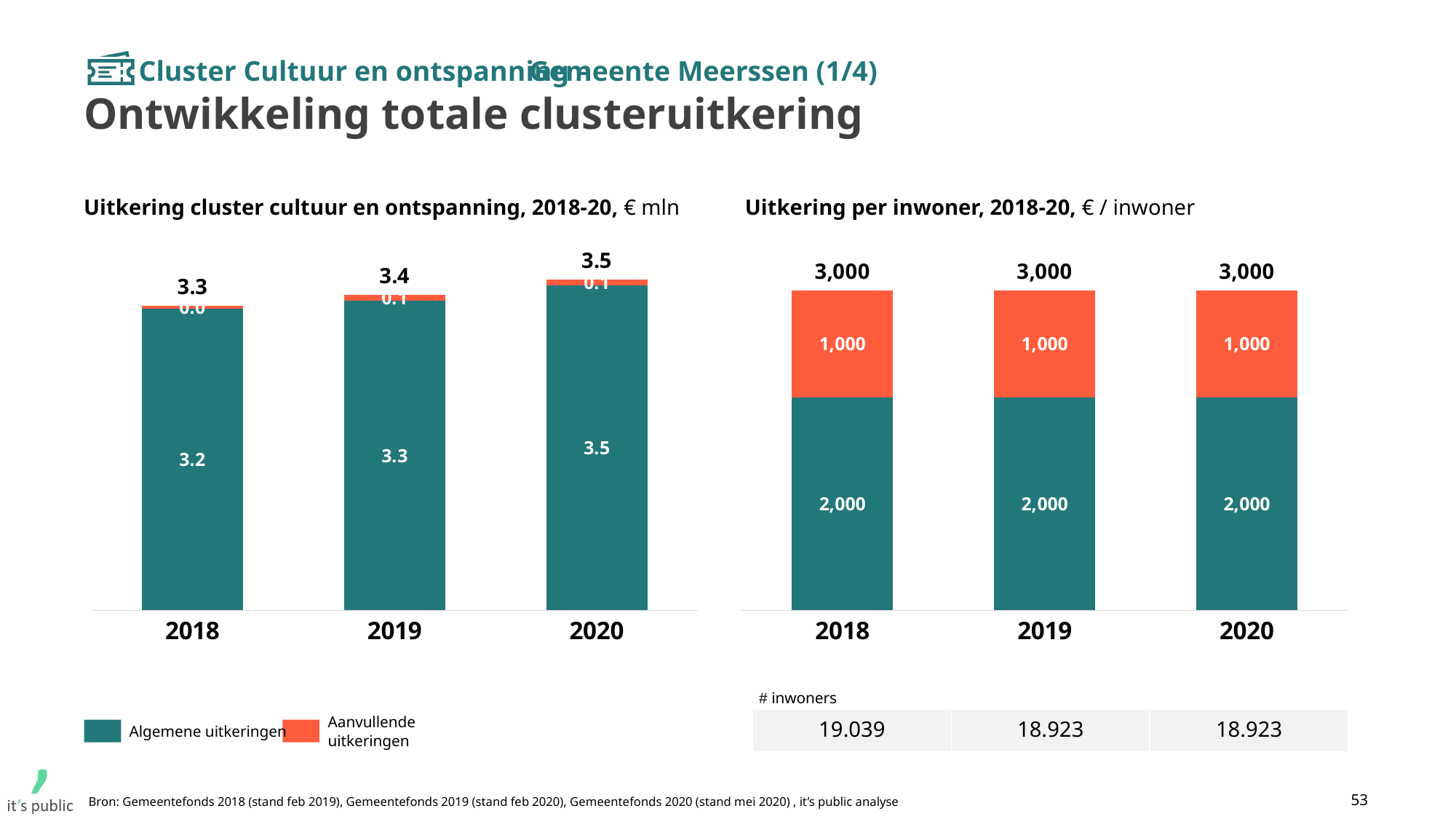
In the right chart (Uitkering per inwoner), what is the value of Aanvullende uitkeringen for 2020? 1,000 How many series does the legend list for the charts on this slide? 2 In the left chart (Uitkering cluster cultuur en ontspanning), which year has the highest total? 2020 In the left chart (Uitkering cluster cultuur en ontspanning), what is the value of Aanvullende uitkeringen for 2019? 0.1 In the right chart (Uitkering per inwoner), what is the value of Algemene uitkeringen for 2019? 2,000 In the left chart (Uitkering cluster cultuur en ontspanning), do the totals rise or fall from 2018 to 2020? rise In the left chart (Uitkering cluster cultuur en ontspanning), what is the difference between the total for 2020 and the total for 2018? 0.2 In the right chart (Uitkering per inwoner), what is the total of the stacked bar for 2018? 3,000 In the left chart (Uitkering cluster cultuur en ontspanning), what is the total value of the bar for 2020? 3.5 What kind of chart is the left chart (Uitkering cluster cultuur en ontspanning)? stacked bar chart In the left chart (Uitkering cluster cultuur en ontspanning), what is the value of Algemene uitkeringen for 2018? 3.2 In the left chart (Uitkering cluster cultuur en ontspanning), which year has the lowest total? 2018